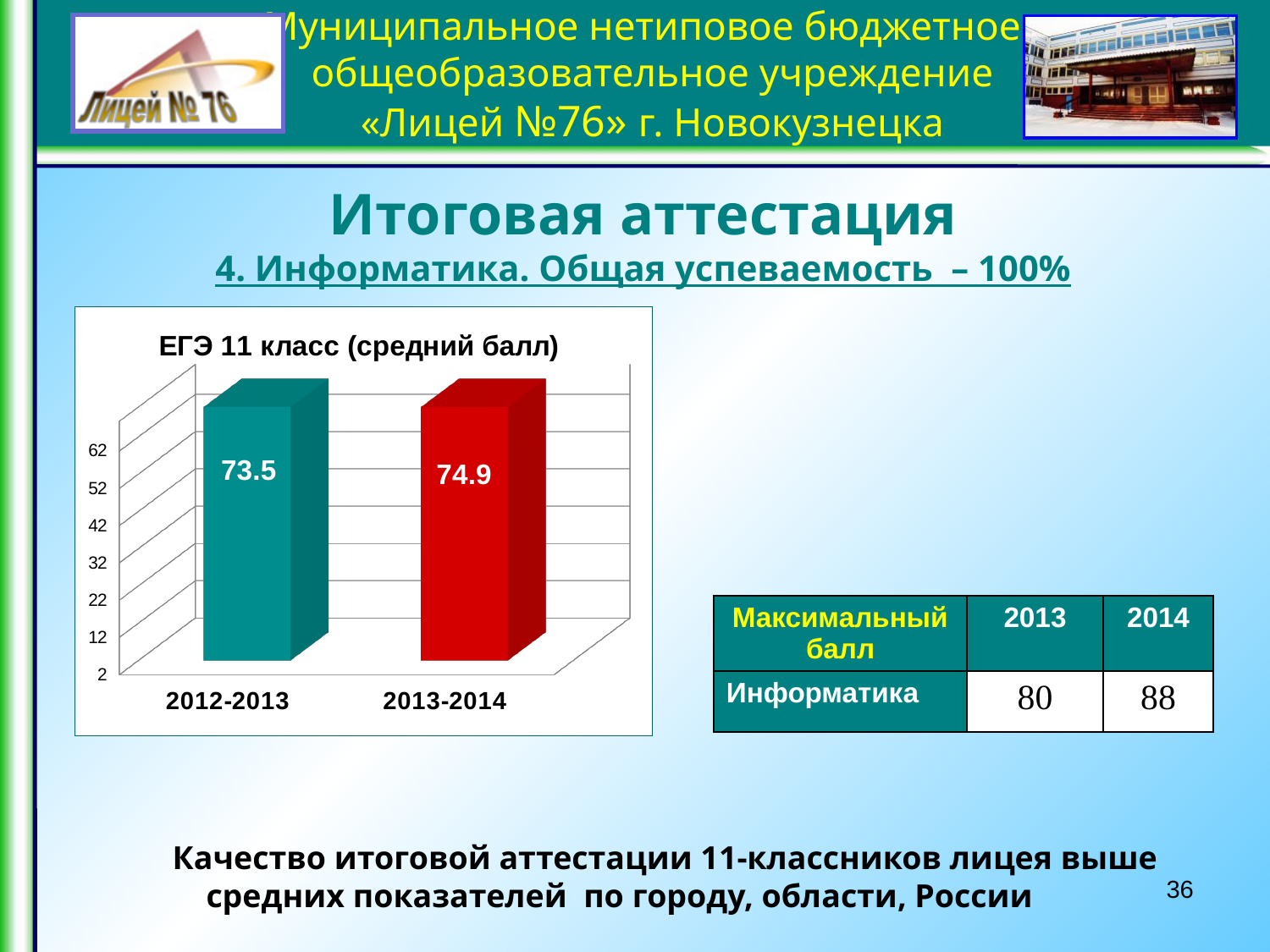
Which category has the highest value in the chart? 2013-2014 How many categories are shown in the chart? 2 What is the difference between the values for 2013-2014 and 2012-2013? 1.4 What is the value for 2012-2013 in the chart? 73.5 Do the values rise or fall from 2012-2013 to 2013-2014? rise Which is larger: the value for 2012-2013 or the value for 2013-2014? 2013-2014 Which category has the lowest value in the chart? 2012-2013 What is the value for 2013-2014 in the chart? 74.9 What kind of chart is shown on the slide? bar chart What colour is the bar for 2013-2014? red Is the value for 2012-2013 greater or less than 62? greater What is the title of the chart? ЕГЭ 11 класс (средний балл)